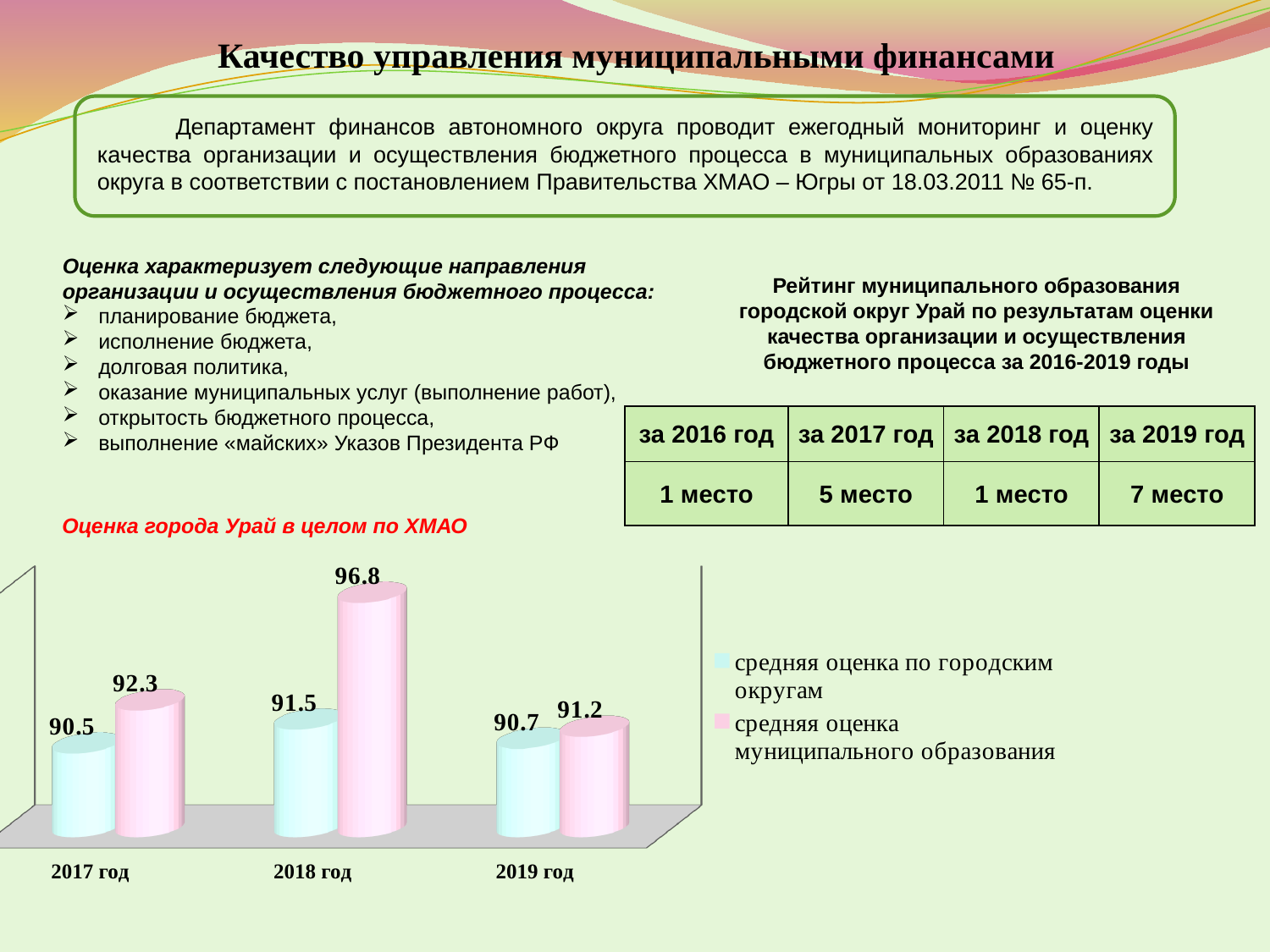
Сколько лет (категорий) показано на диаграмме? 3 В каком году средняя оценка по городским округам была наименьшей? 2017 год Какого типа диаграмма показана на слайде? столбчатая (bar chart) Сколько рядов данных указано в легенде диаграммы? 2 Какое значение имеет средняя оценка муниципального образования за 2019 год? 91.2 Что больше в 2019 году: средняя оценка по городским округам или средняя оценка муниципального образования? средняя оценка муниципального образования На сколько средняя оценка муниципального образования превышает среднюю оценку по городским округам в 2018 году? 5.3 Каким цветом на диаграмме показана средняя оценка муниципального образования? розовым Какое значение имеет средняя оценка по городским округам за 2017 год на диаграмме? 90.5 На сколько средняя оценка муниципального образования превышает среднюю оценку по городским округам в 2017 году? 1.8 Какое значение имеет средняя оценка муниципального образования за 2018 год на диаграмме? 96.8 В каком году средняя оценка муниципального образования была наибольшей? 2018 год